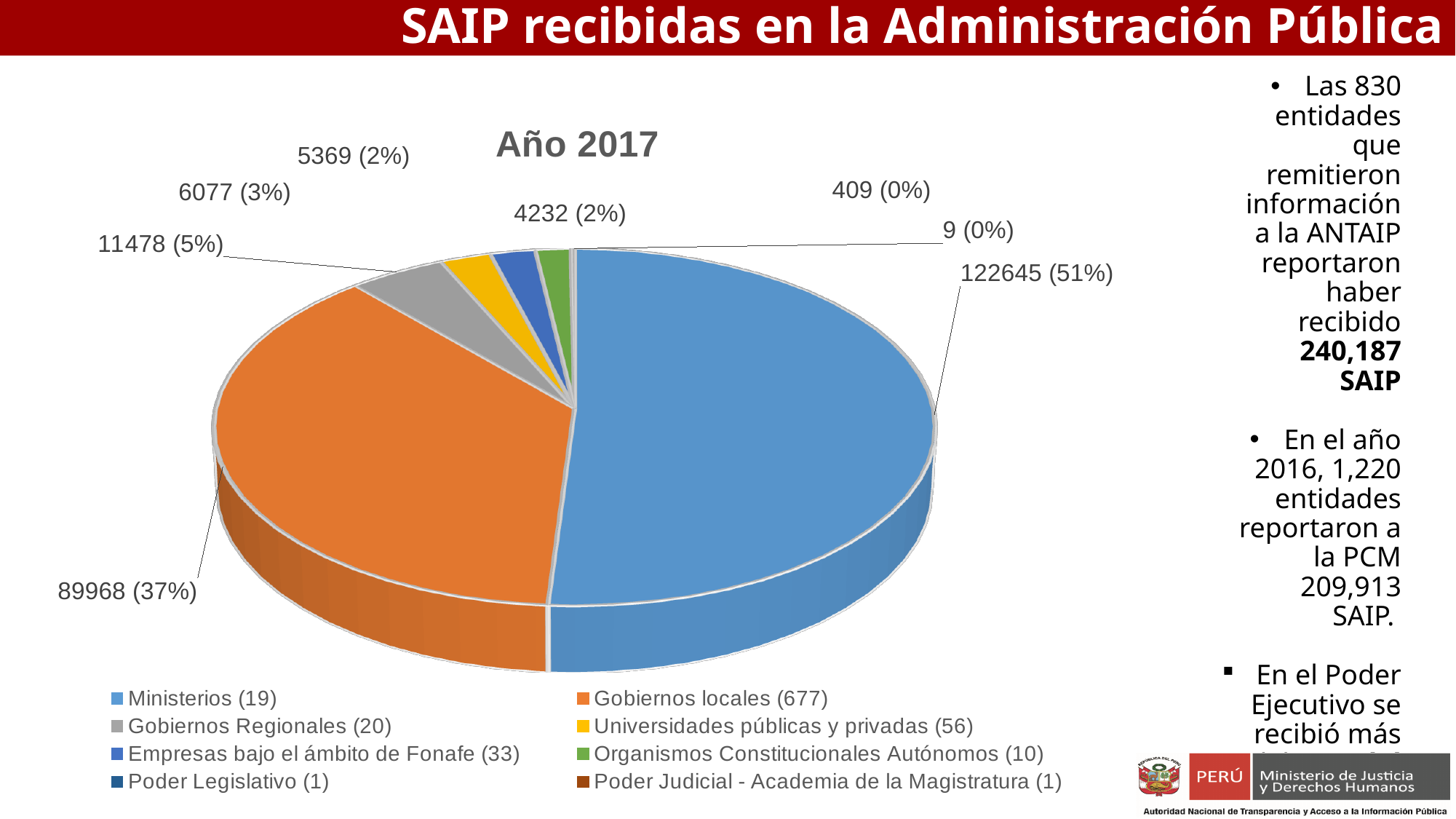
What value is shown for Gobiernos locales (677) in the pie chart? 89968 (37%) What share of the pie does Ministerios (19) represent? 51% Which category has the smallest slice in the pie chart? Poder Judicial - Academia de la Magistratura (1) How many categories does the legend of the pie chart list? 8 What value is shown for Ministerios (19) in the pie chart? 122645 (51%) What value is shown for Universidades públicas y privadas (56) in the pie chart? 6077 (3%) Which category has the largest slice in the pie chart? Ministerios (19) What is the title of the pie chart? Año 2017 What is the difference between the values for Ministerios (19) and Gobiernos locales (677)? 32677 What kind of chart is shown on the slide? Pie chart What value is shown for Gobiernos Regionales (20) in the pie chart? 11478 (5%) Which is larger, the value for Gobiernos Regionales (20) or for Universidades públicas y privadas (56)? Gobiernos Regionales (20)